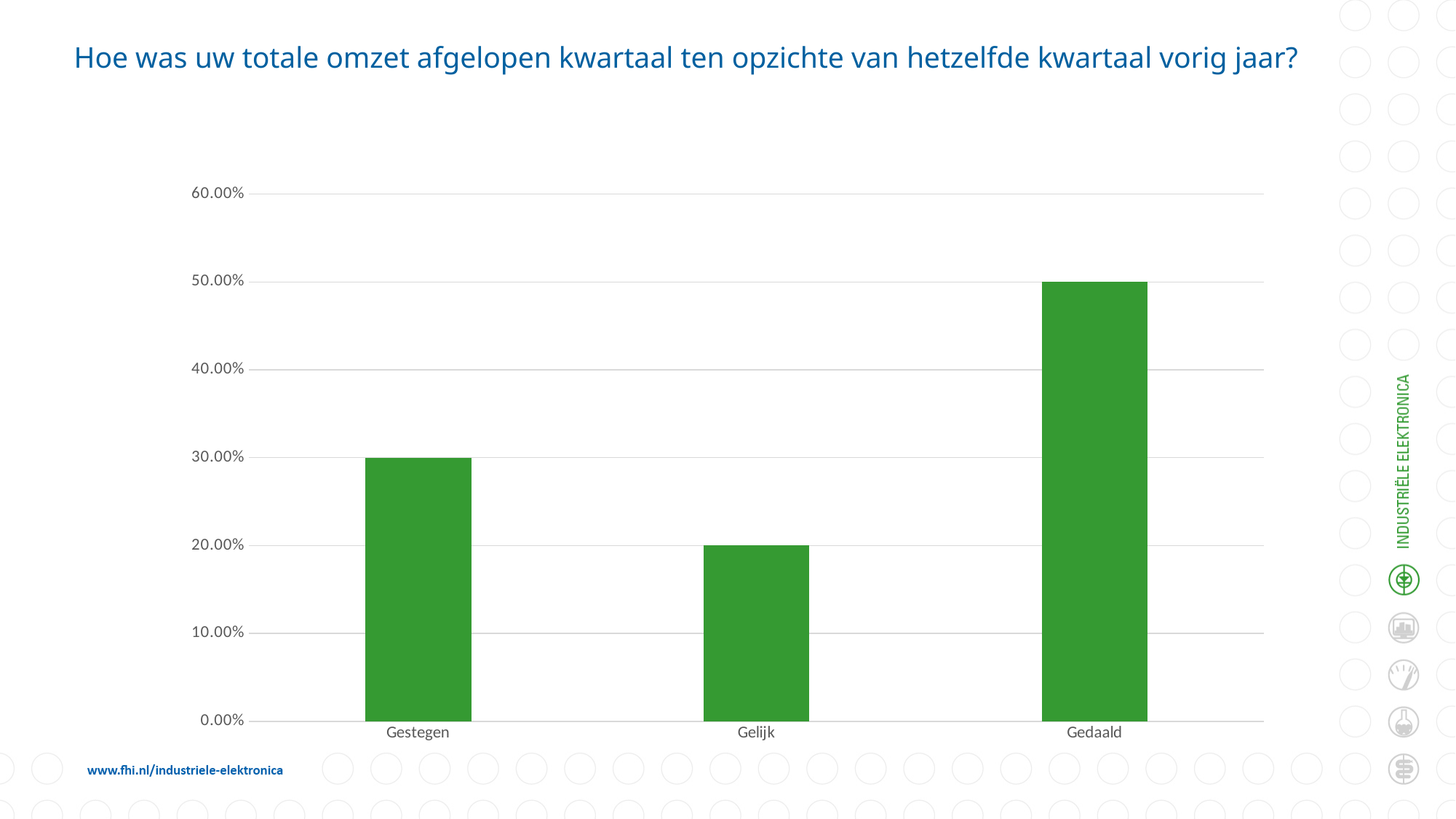
What kind of chart is shown on the slide? bar chart How many categories are shown on the x axis? 3 What is the value for Gestegen? 30.00% Which category has the lowest value? Gelijk What is the value for Gedaald? 50.00% What is the difference between the values for Gedaald and Gestegen? 20.00% What is the title of the chart? Hoe was uw totale omzet afgelopen kwartaal ten opzichte van hetzelfde kwartaal vorig jaar? What is the difference between the values for Gestegen and Gelijk? 10.00% What is the value for Gelijk? 20.00% Is the value for Gedaald greater or less than 40.00%? greater Which category has the highest value? Gedaald Which is larger, the value for Gestegen or the value for Gelijk? Gestegen